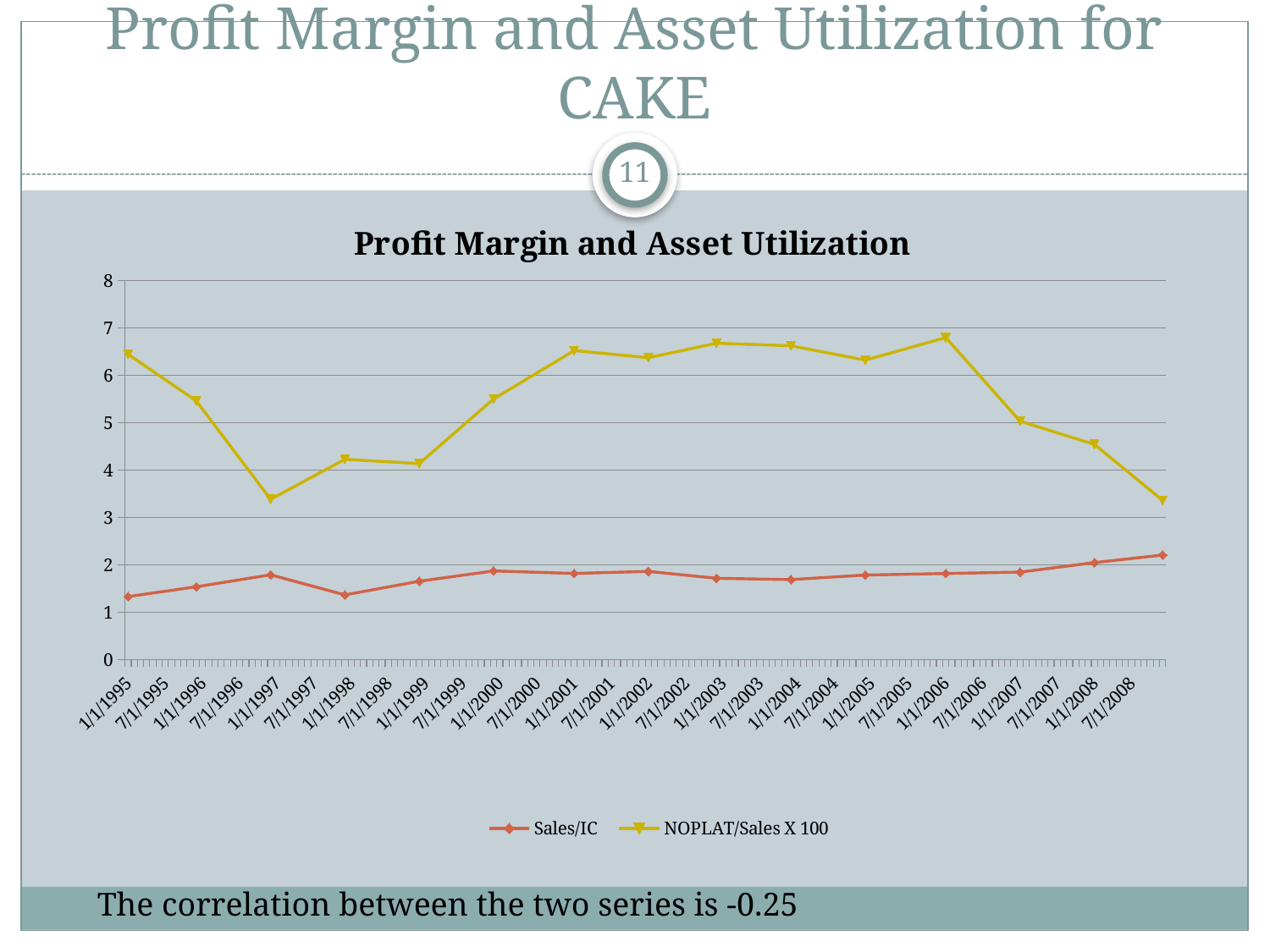
What kind of chart is shown on the slide? line chart Which series is drawn in yellow? NOPLAT/Sales X 100 At which date does the Sales/IC series reach its highest value? 7/1/2008 Is the value of Sales/IC at 7/1/2008 greater or less than 2? greater Which series has the higher value at 1/1/2000, Sales/IC or NOPLAT/Sales X 100? NOPLAT/Sales X 100 Is the value of NOPLAT/Sales X 100 larger at 1/1/1995 or at 1/1/1997? 1/1/1995 Is the value of NOPLAT/Sales X 100 at 1/1/1997 greater or less than 4? less How many series does the legend list? 2 Is the value of Sales/IC at 1/1/1995 greater or less than 2? less What is the title of the chart? Profit Margin and Asset Utilization Does the NOPLAT/Sales X 100 series rise or fall from 1/1/2006 to 7/1/2008? fall